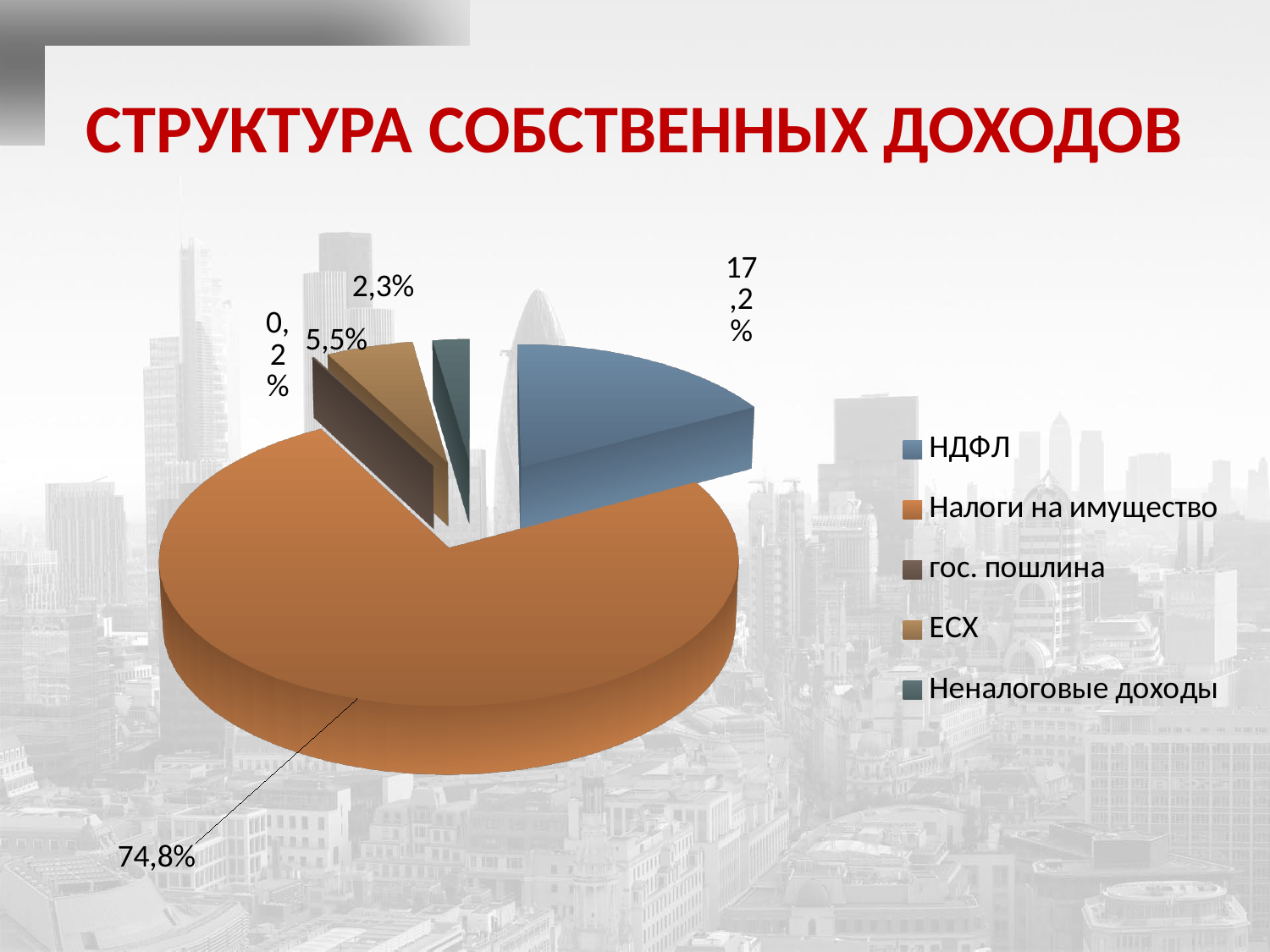
What share of the pie does Неналоговые доходы have? 2,3% What share of the pie does Налоги на имущество have? 74,8% What share of the pie does ЕСХ have? 5,5% What share of the pie does гос. пошлина have? 0,2% What share of the pie does НДФЛ have? 17,2% What type of chart is shown on the slide? Pie chart Which is larger, the share for НДФЛ or the share for ЕСХ? НДФЛ What is the title of the chart on the slide? СТРУКТУРА СОБСТВЕННЫХ ДОХОДОВ What is the difference between the shares of Налоги на имущество and НДФЛ? 57,6% How many categories does the legend list? 5 Which category has the largest share of the pie? Налоги на имущество Which category has the smallest share of the pie? гос. пошлина